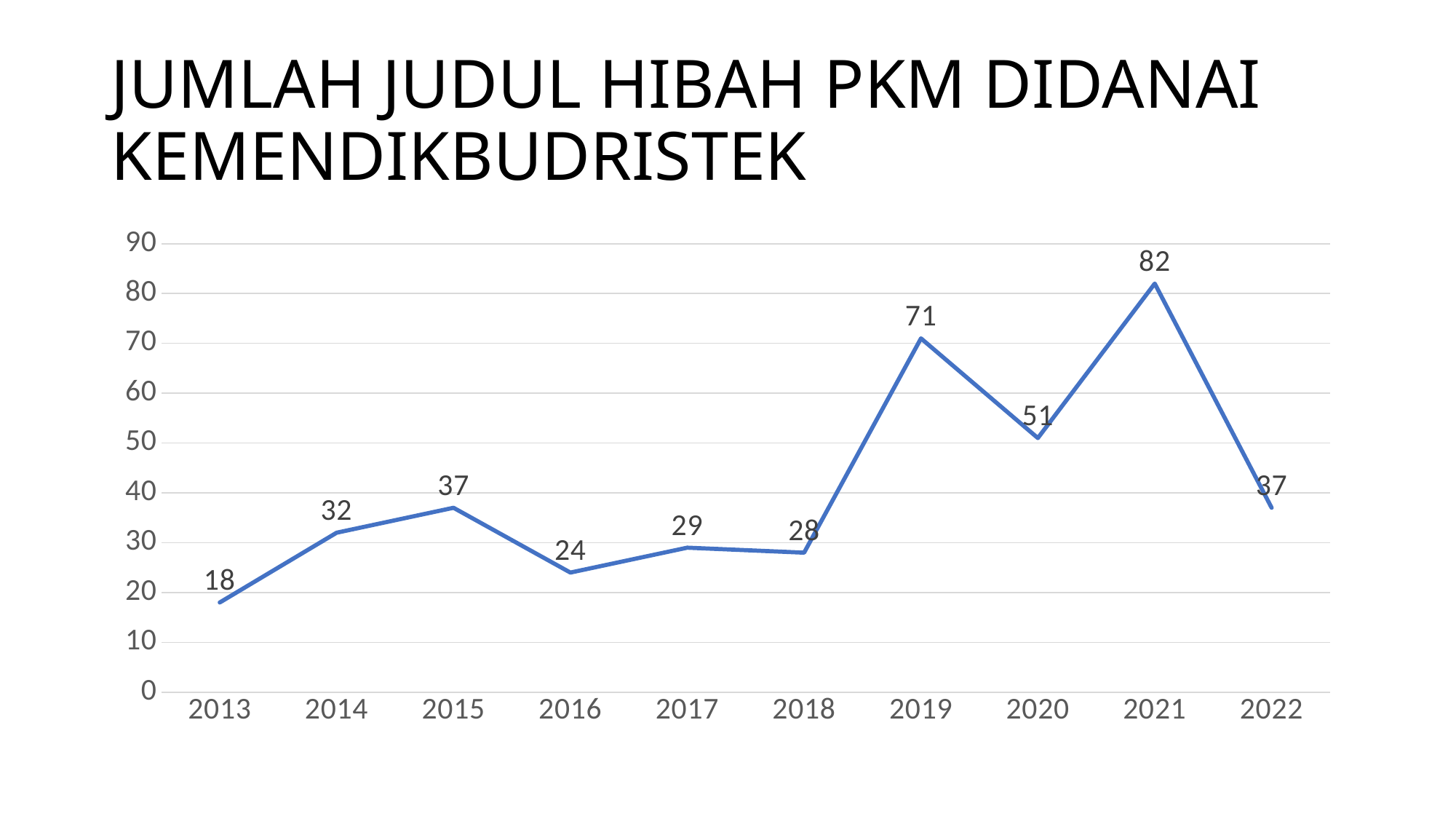
Which is larger, the value for 2015 or the value for 2016? 2015 What is the value for 2022? 37 What is the title of the chart on the slide? JUMLAH JUDUL HIBAH PKM DIDANAI KEMENDIKBUDRISTEK Is the value for 2020 greater or less than 60? less What kind of chart is shown on the slide? line chart Which year has the lowest value? 2013 How many years are plotted on the chart? 10 Which year has the highest value? 2021 What is the value for 2019? 71 What is the difference between the values for 2021 and 2020? 31 What is the value for 2013? 18 What is the difference between the values for 2019 and 2018? 43